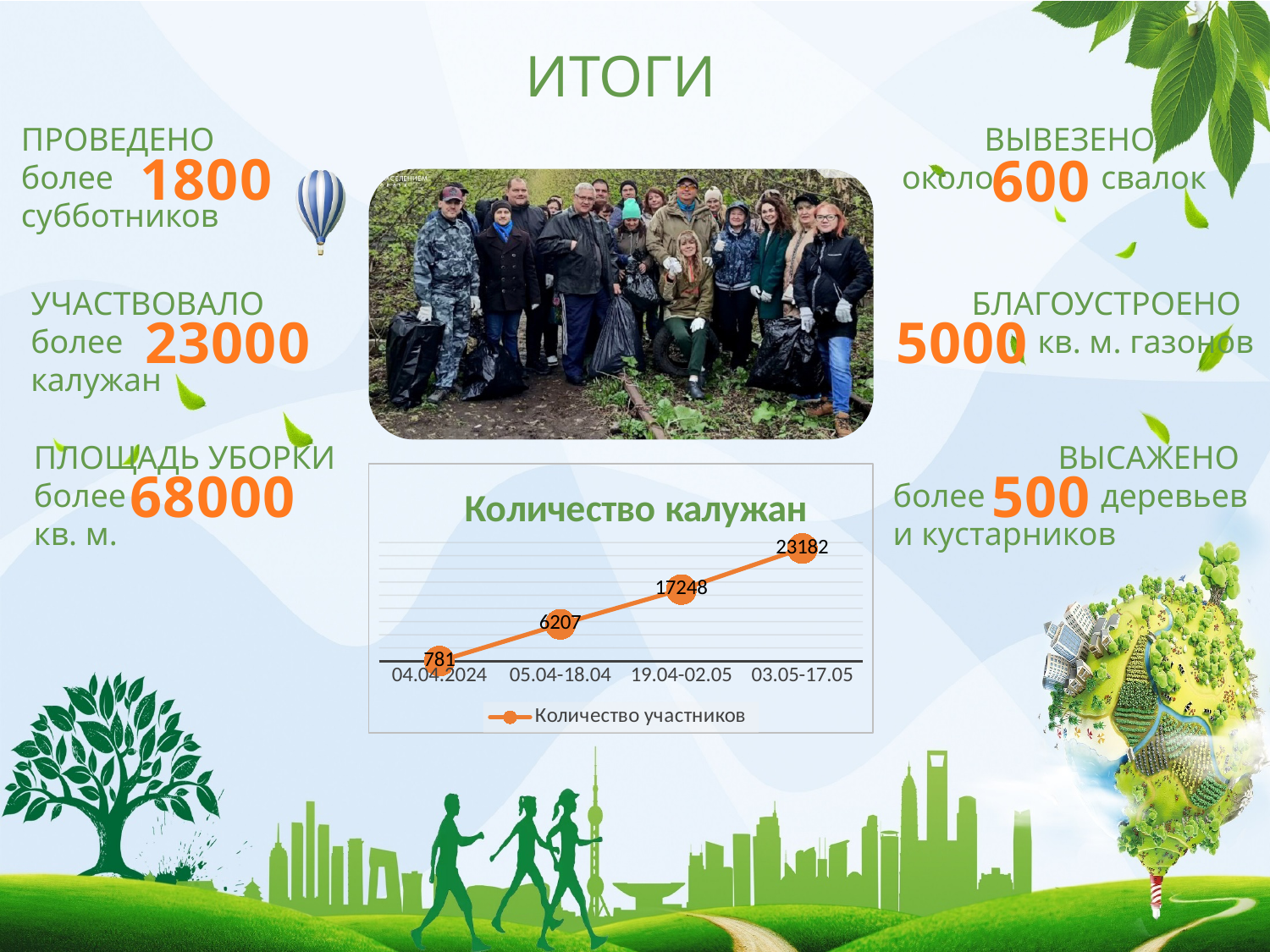
What type of chart is shown on the slide? line chart What is the value for 19.04-02.05 in the chart? 17248 What is the value for 05.04-18.04 in the chart? 6207 What is the title of the chart on the slide? Количество калужан Which period has the lowest value in the chart? 04.04.2024 What is the value for 03.05-17.05 in the chart? 23182 Which is larger: the value for 05.04-18.04 or the value for 19.04-02.05? 19.04-02.05 Do the values rise or fall along the x axis of the chart? rise What is the value for 04.04.2024 in the chart? 781 What is the difference between the values for 03.05-17.05 and 19.04-02.05? 5934 How many data points are plotted in the chart? 4 Which period has the highest value in the chart? 03.05-17.05